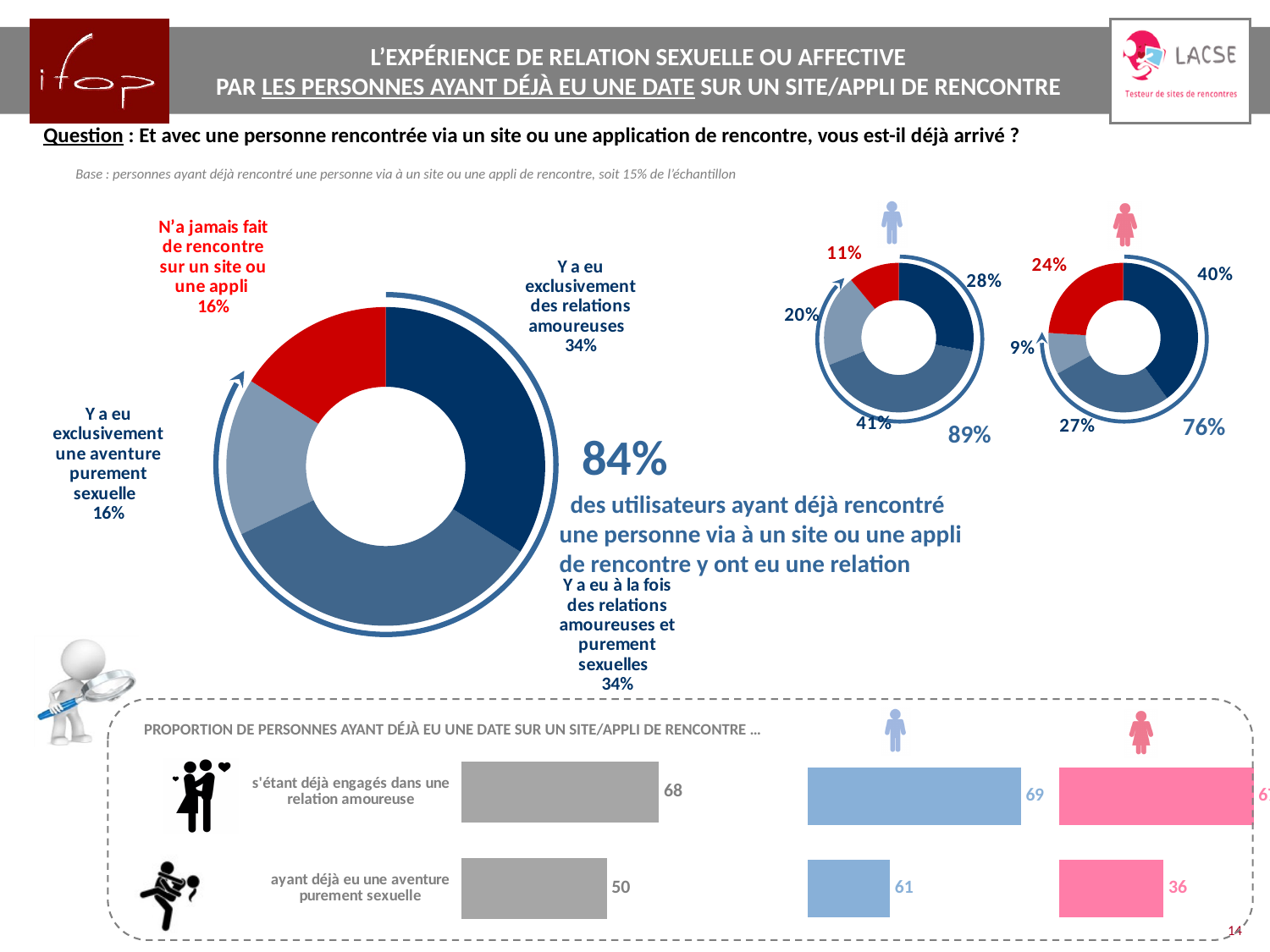
In the bottom bar chart, which is larger for 'ayant déjà eu une aventure purement sexuelle': the men's (blue) bar or the women's (pink) bar? Men's (blue) bar In the bottom bar chart, what is the difference between the men's (blue) value and the women's (pink) value for 'ayant déjà eu une aventure purement sexuelle'? 25 How many slices does the large donut chart in the centre-left of the slide have? 4 On the large donut chart in the centre-left of the slide, what is the difference between the share for 'Y a eu exclusivement des relations amoureuses' and the share for 'N'a jamais fait de rencontre sur un site ou une appli'? 18 points On the small donut chart for men (top right, blue figure), what is the largest slice value? 41% On the small donut chart for women (top right, pink figure), what is the value of the red slice? 24% On the large donut chart in the centre-left of the slide, what percentage corresponds to 'Y a eu exclusivement une aventure purement sexuelle'? 16% On the large donut chart in the centre-left of the slide, what percentage corresponds to 'Y a eu exclusivement des relations amoureuses'? 34% On the large donut chart in the centre-left of the slide, what percentage corresponds to 'N'a jamais fait de rencontre sur un site ou une appli'? 16% What type of chart is the large chart in the centre-left of the slide? Donut chart In the bottom bar chart, what is the grey bar value for 'ayant déjà eu une aventure purement sexuelle'? 50 On the small donut chart for women (top right, pink figure), what is the smallest slice value? 9%